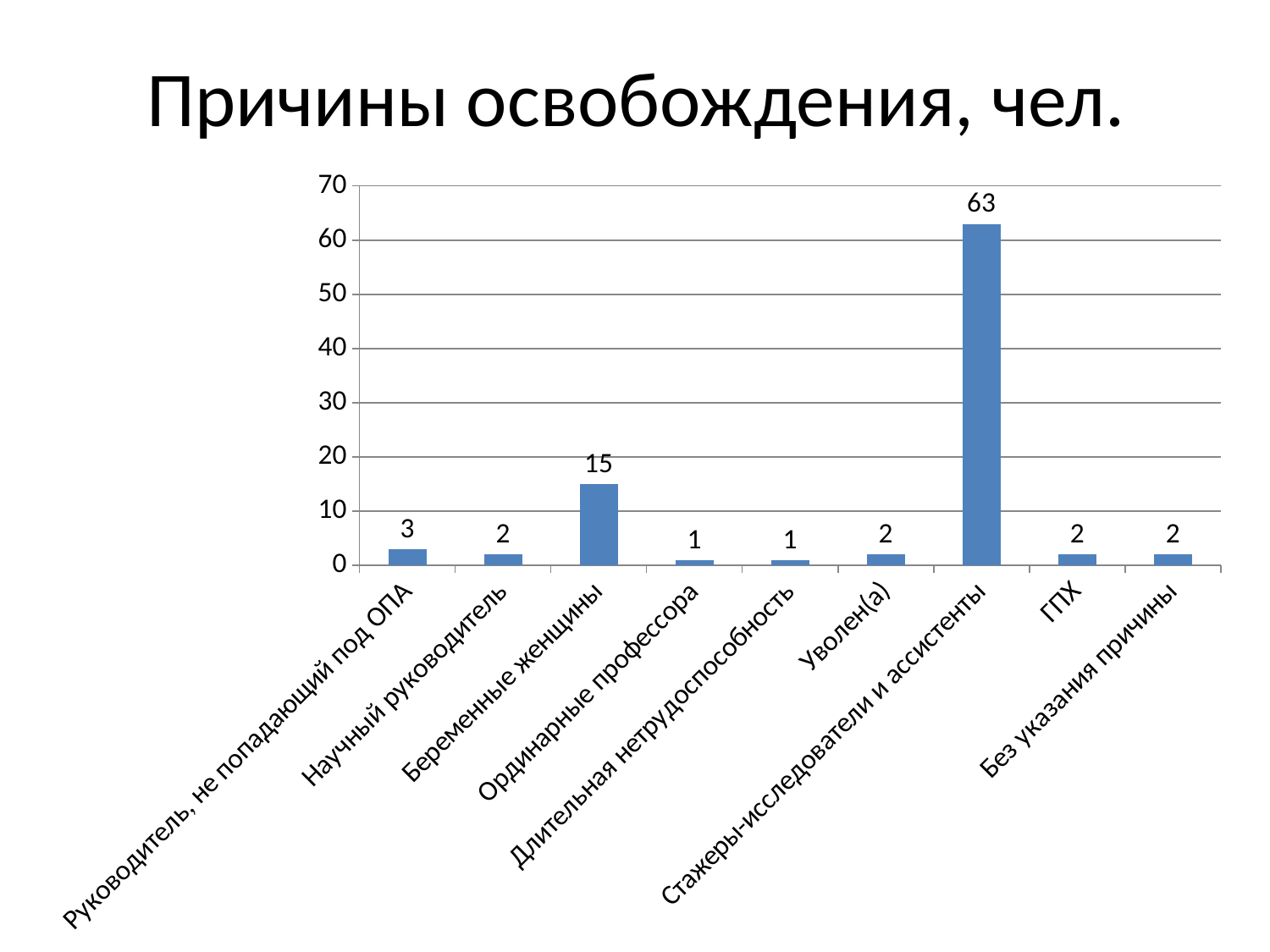
What is the value for Руководитель, не попадающий под ОПА? 3 What is the title of the chart? Причины освобождения, чел. What is the value for Ординарные профессора? 1 Which category has the highest value? Стажеры-исследователи и ассистенты What is the value for Стажеры-исследователи и ассистенты? 63 What is the difference between the values for Беременные женщины and Руководитель, не попадающий под ОПА? 12 How many categories are shown on the x axis? 9 Is the value for Стажеры-исследователи и ассистенты greater or less than 60? greater What kind of chart is shown on the slide? bar chart What is the value for Беременные женщины? 15 Which is larger, the value for Беременные женщины or the value for ГПХ? Беременные женщины What is the difference between the values for Стажеры-исследователи и ассистенты and Беременные женщины? 48